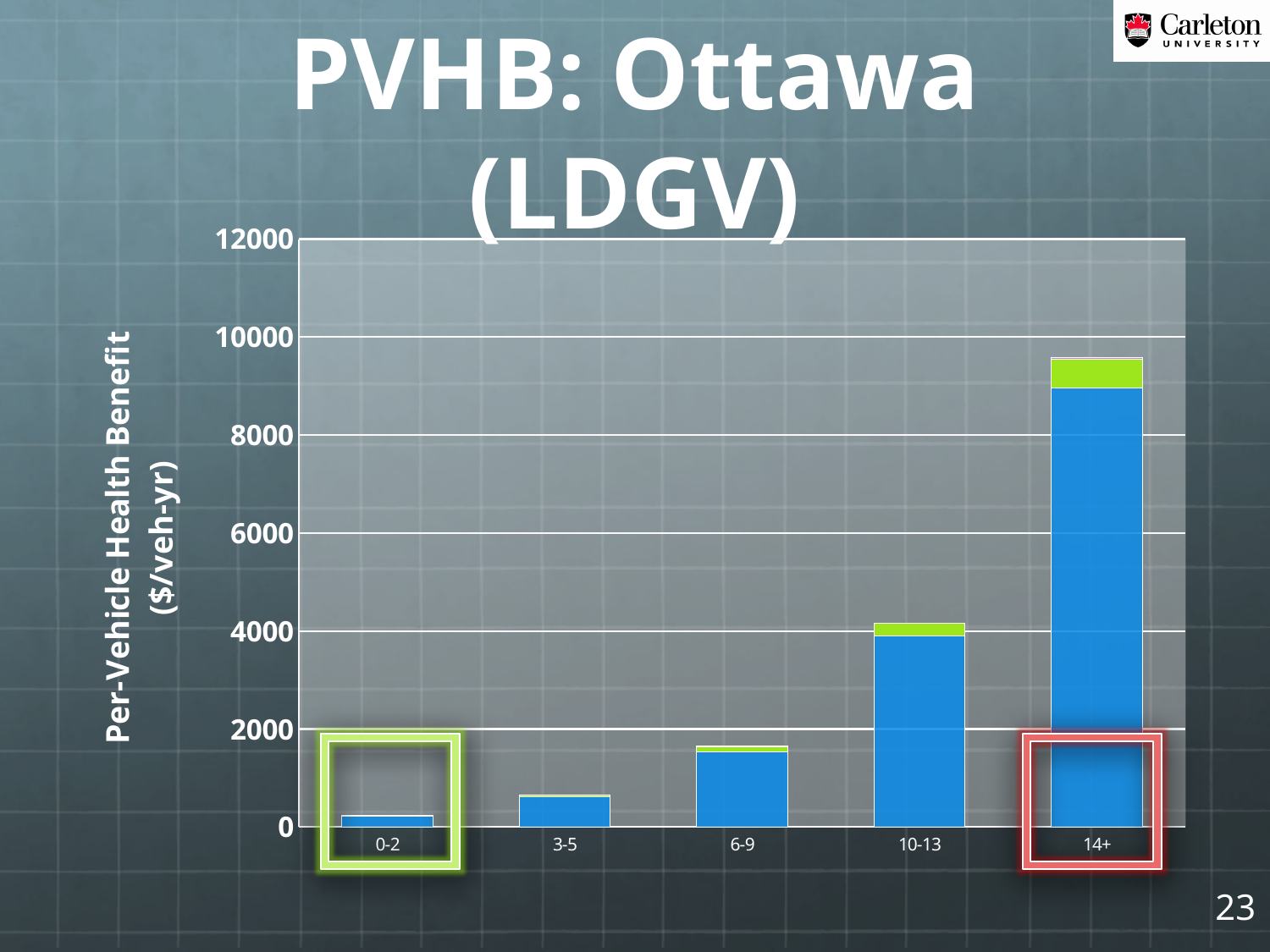
Which category has a larger per-vehicle health benefit, 10-13 or 6-9? 10-13 Is the total value for the 3-5 category greater or less than 2000? less Which category has the lowest per-vehicle health benefit? 0-2 What is the label of the y axis? Per-Vehicle Health Benefit ($/veh-yr) Is the total value for the 6-9 category greater or less than 2000? less Do the bar values rise or fall as you move from 0-2 to 14+ along the x axis? rise How many vehicle age categories are shown on the x axis? 5 Is the total value for the 10-13 category greater or less than 2000? greater What kind of chart is shown on the slide? bar chart Which category has the highest per-vehicle health benefit? 14+ What is the title of the slide containing the chart? PVHB: Ottawa (LDGV)